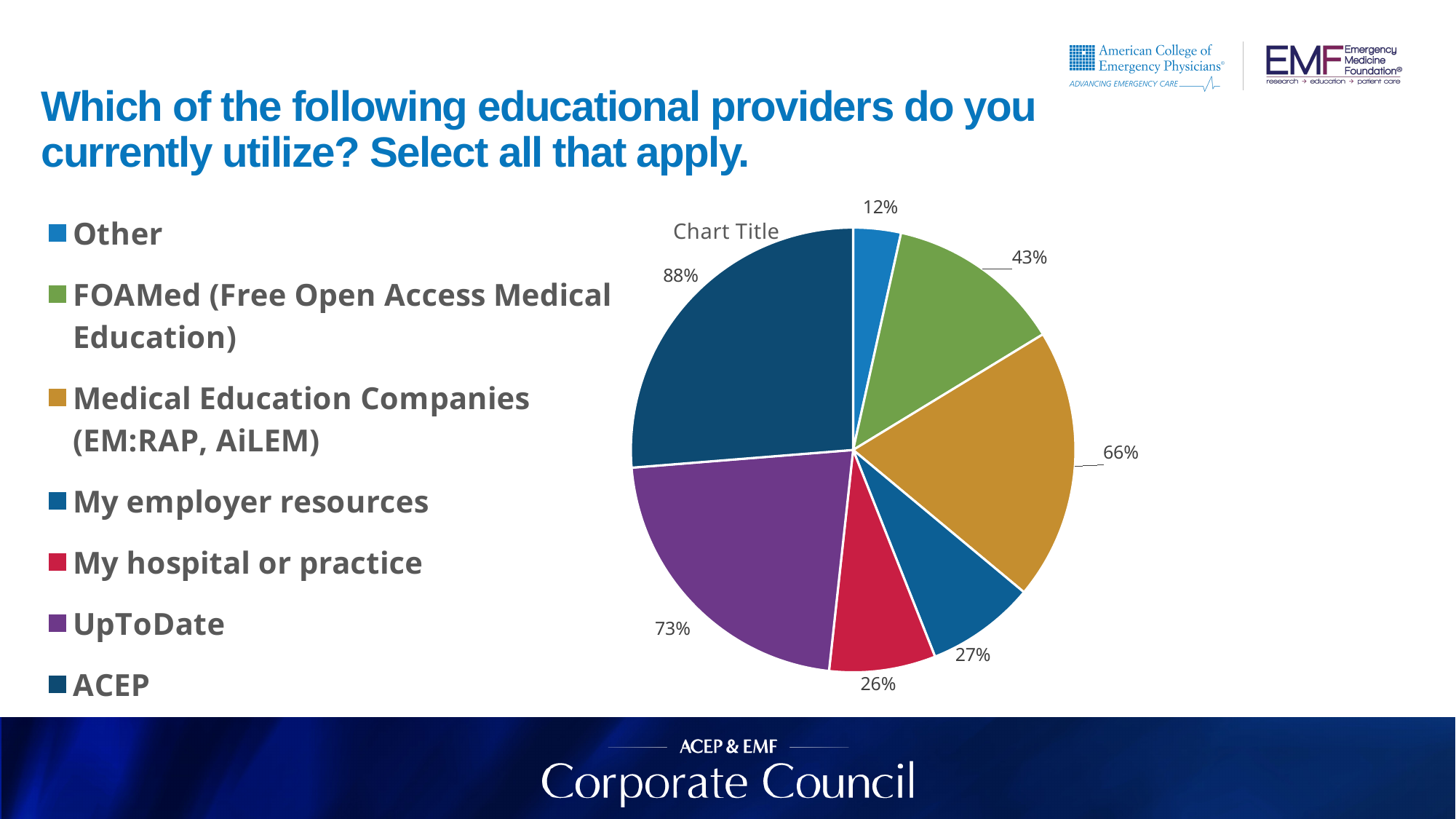
How many categories does the legend of the pie chart list? 7 Which category has the highest value in the pie chart? ACEP What value is shown for ACEP in the pie chart? 88% What is the difference between the values for Medical Education Companies (EM:RAP, AiLEM) and FOAMed (Free Open Access Medical Education)? 23% What value is shown for My hospital or practice? 26% Which category has the lowest value in the pie chart? Other Which is larger, the value for My employer resources or the value for FOAMed (Free Open Access Medical Education)? FOAMed (Free Open Access Medical Education) What value is shown for Medical Education Companies (EM:RAP, AiLEM)? 66% What type of chart is shown on the slide? Pie chart What is the difference between the values for ACEP and UpToDate? 15% What value is shown for FOAMed (Free Open Access Medical Education)? 43% What value is shown for UpToDate in the pie chart? 73%